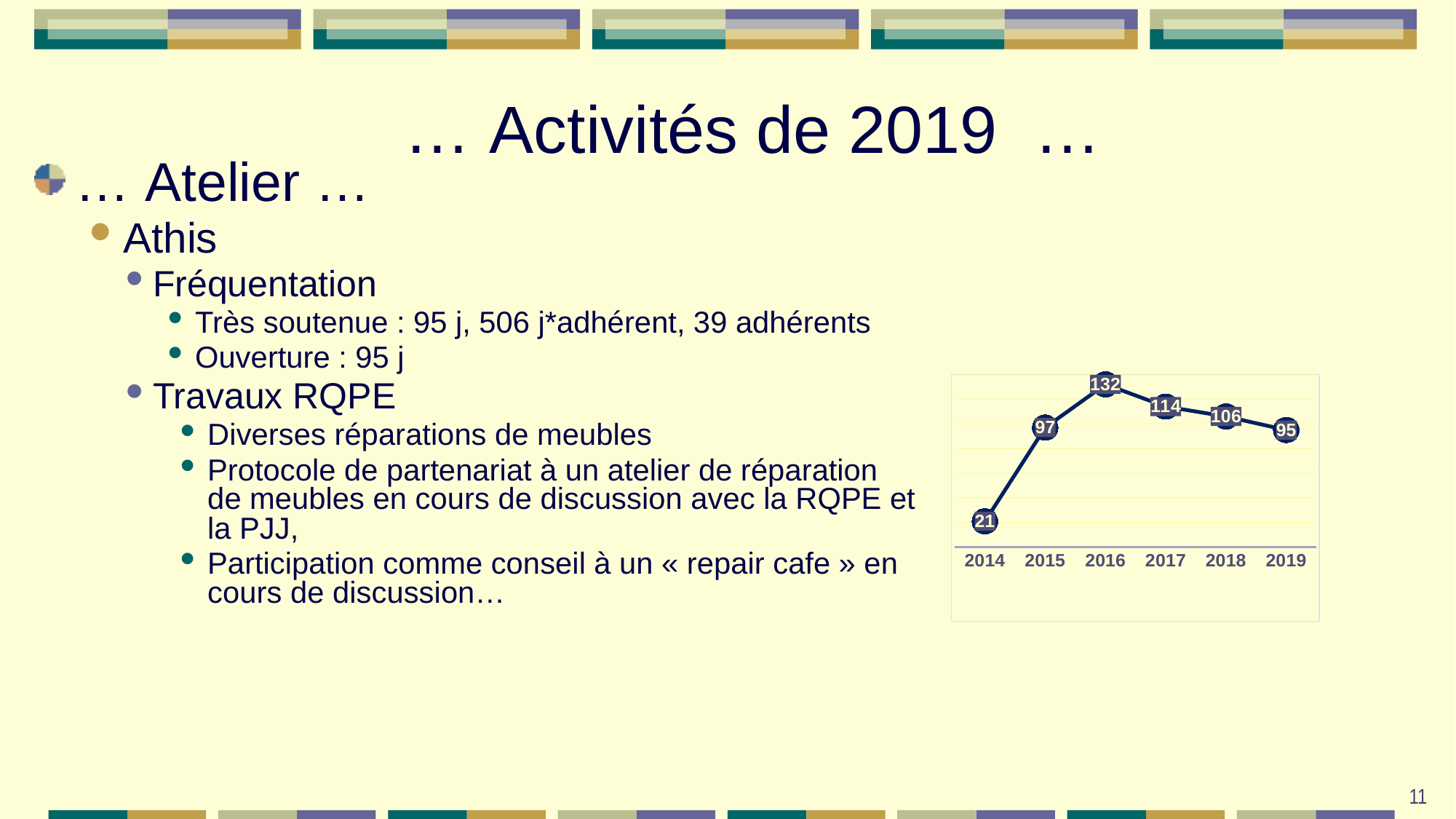
Which year has the lowest value? 2014 What is the value plotted for 2014? 21 What is the value plotted for 2017? 114 What is the difference between the values for 2016 and 2019? 37 Which is larger, the value for 2017 or the value for 2018? 2017 What kind of chart is shown on the slide? line chart What is the value plotted for 2016? 132 What is the difference between the values for 2015 and 2014? 76 Do the values rise or fall from 2016 to 2019? fall Which year has the highest value? 2016 How many years are plotted on the chart? 6 What is the value plotted for 2019? 95